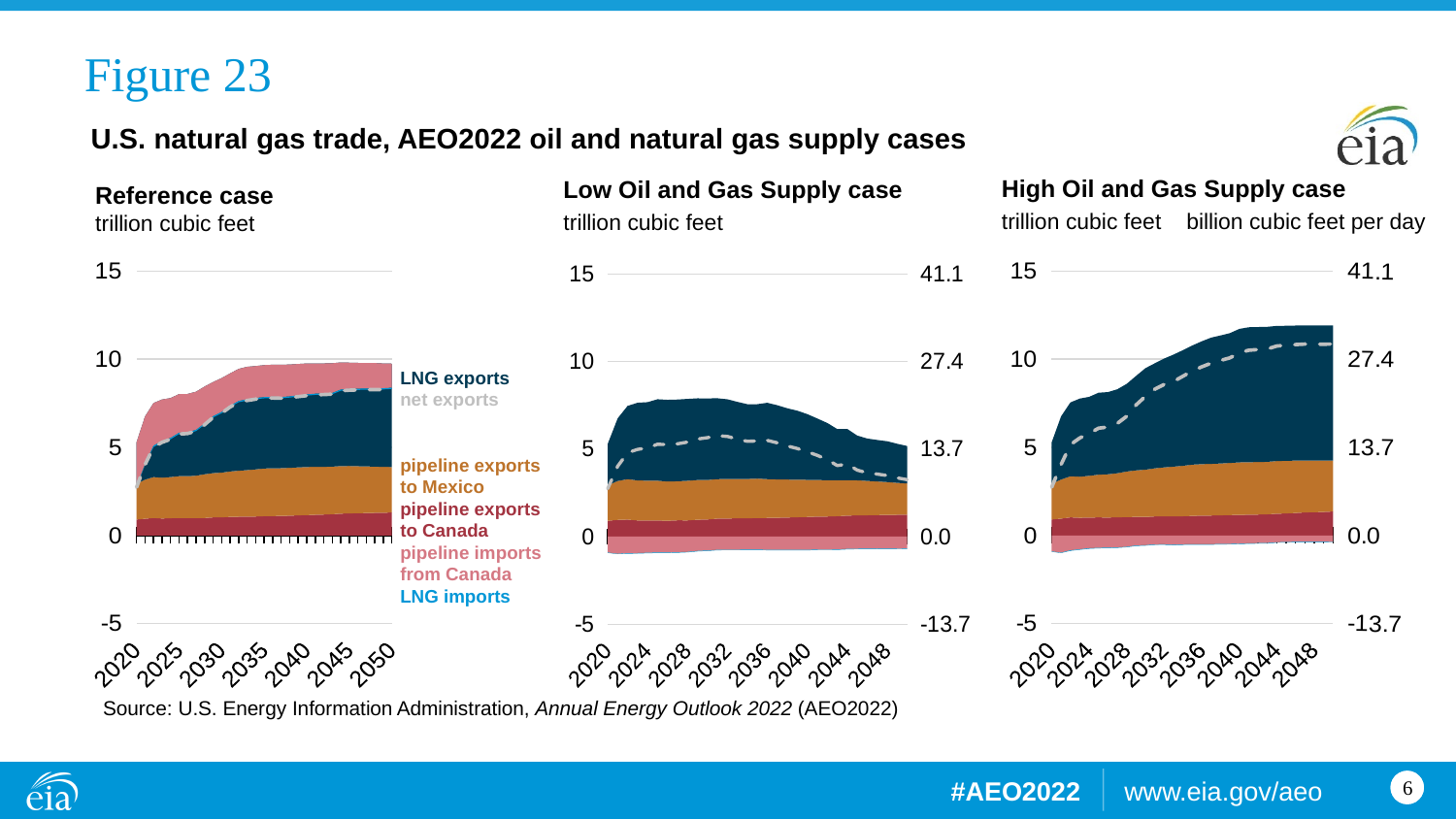
What is the title of the overall figure on the slide? U.S. natural gas trade, AEO2022 oil and natural gas supply cases How many series does the legend next to the Reference case chart list? 6 In the High Oil and Gas Supply case chart, what unit is shown on the right-hand axis? billion cubic feet per day In the High Oil and Gas Supply case chart, is the net exports value in 2048 greater or less than 10 trillion cubic feet? greater In the Low Oil and Gas Supply case chart, is the net exports value in 2048 greater or less than 5 trillion cubic feet? less What kind of chart is used for the Reference case panel? Stacked area chart How many charts (cases) are shown on the slide? 3 In the Reference case chart, is the net exports value in 2050 greater or less than 10 trillion cubic feet? less Which case shows the lowest net exports by the end of the projection period? Low Oil and Gas Supply case Which case shows the highest net exports by the end of the projection period? High Oil and Gas Supply case In the High Oil and Gas Supply case chart, does the net exports line generally rise or fall from 2020 to 2048? rise